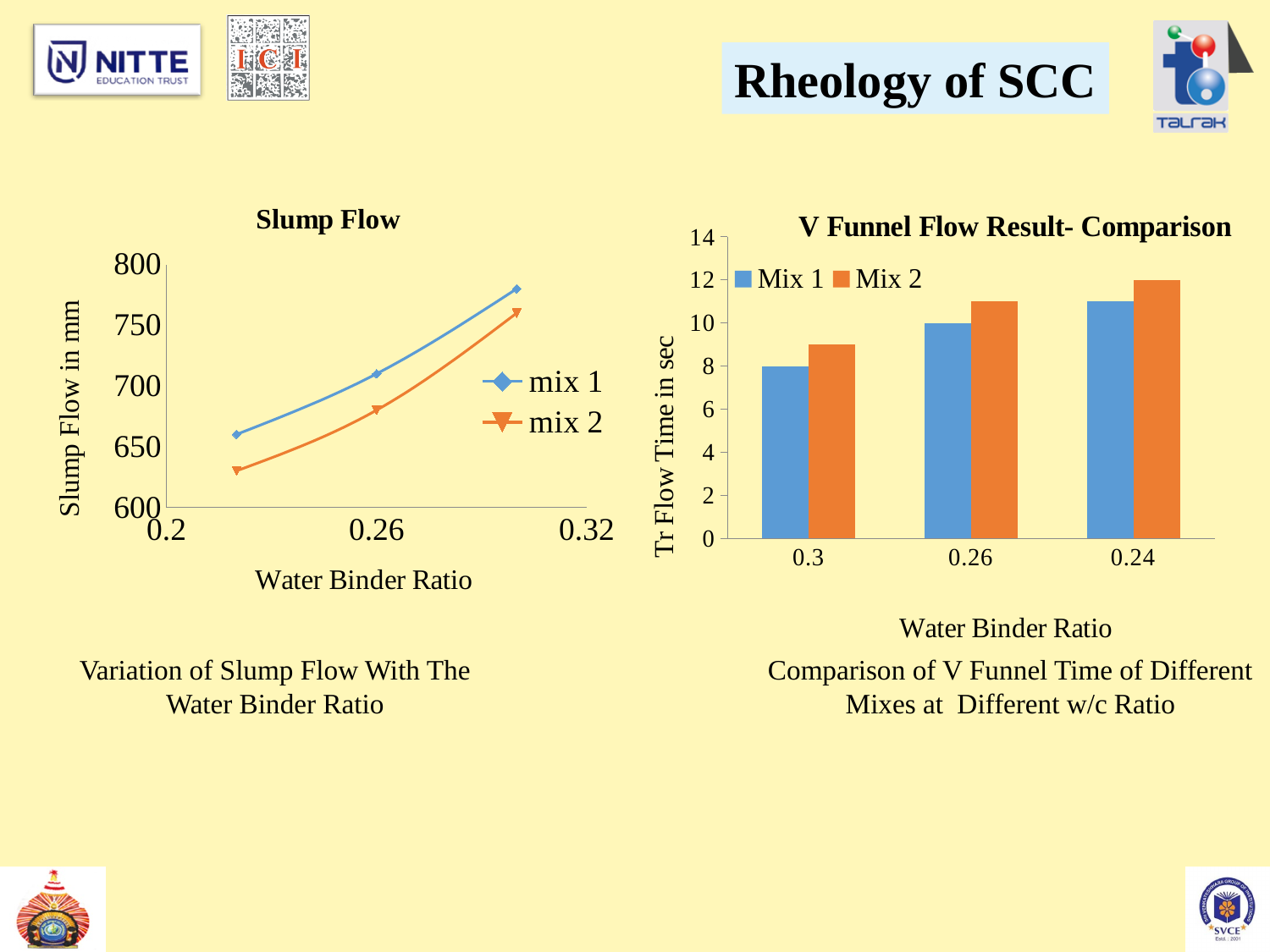
In the V Funnel Flow Result- Comparison chart, what is the difference between Mix 1 at 0.26 and Mix 1 at 0.3? 2 In the Slump Flow chart, what kind of chart is it? line chart In the Slump Flow chart, does the mix 1 line rise or fall as the water binder ratio increases? rises In the V Funnel Flow Result- Comparison chart, what is the Tr Flow Time for Mix 1 at water binder ratio 0.3? 8 In the V Funnel Flow Result- Comparison chart, at water binder ratio 0.3, which is larger, Mix 1 or Mix 2? Mix 2 In the V Funnel Flow Result- Comparison chart, what is the Tr Flow Time for Mix 2 at water binder ratio 0.24? 12 In the V Funnel Flow Result- Comparison chart, what is the Tr Flow Time for Mix 1 at water binder ratio 0.26? 10 In the V Funnel Flow Result- Comparison chart, what kind of chart is it? bar chart In the Slump Flow chart, how many series does the legend list? 2 In the Slump Flow chart, is the value for mix 2 at its lowest water binder ratio greater or less than 650? less In the V Funnel Flow Result- Comparison chart, how many water binder ratio categories are shown on the x axis? 3 In the V Funnel Flow Result- Comparison chart, which water binder ratio has the highest Mix 2 value? 0.24